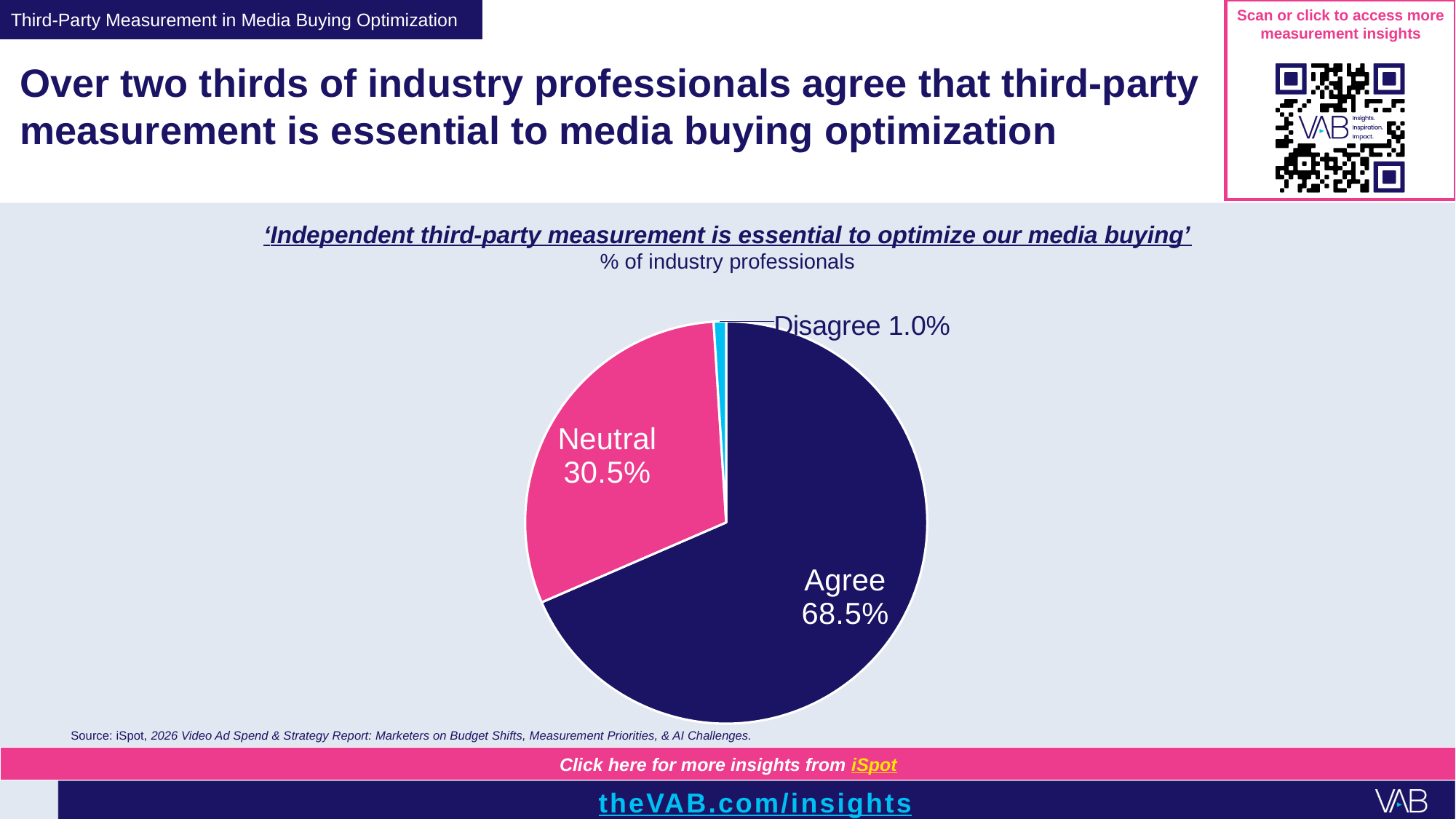
What colour is the Neutral slice of the pie chart? Pink What percentage of industry professionals agree that independent third-party measurement is essential to optimize their media buying? 68.5% What percentage of industry professionals disagree with the statement? 1.0% Which is larger, the Neutral share or the Disagree share? Neutral How many response categories are shown in the pie chart? 3 What percentage of industry professionals are neutral on the statement about third-party measurement? 30.5% Which response has the largest share of the pie? Agree What is the source of the data shown in the chart? iSpot, 2026 Video Ad Spend & Strategy Report What type of chart is shown on the slide? Pie chart Which response has the smallest share of the pie? Disagree How many percentage points larger is the Agree share than the Neutral share? 38.0 percentage points What is the difference between the Neutral share and the Disagree share? 29.5 percentage points